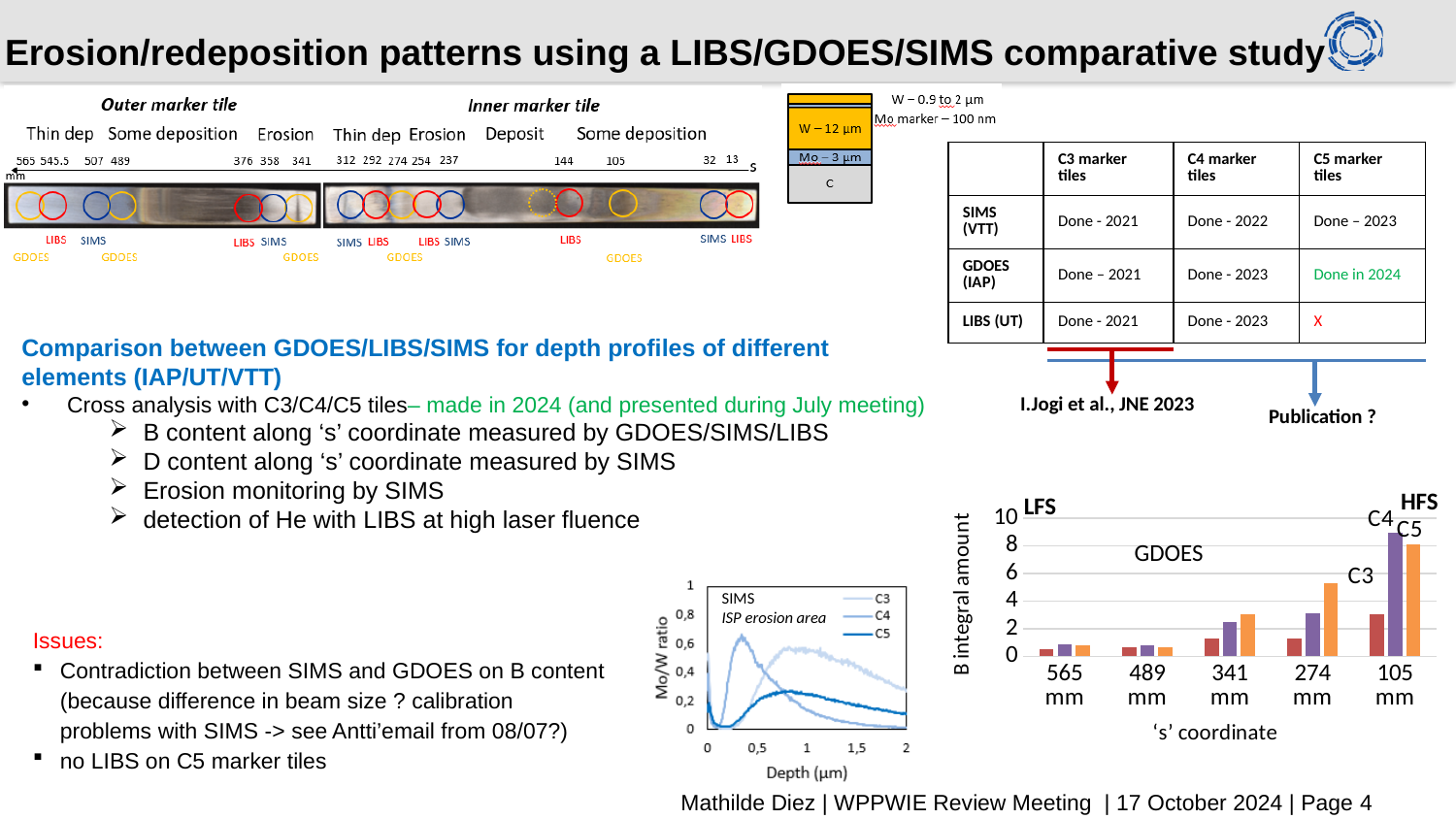
In the GDOES bar chart, which 's' coordinate has the highest C4 bar? 105 mm In the GDOES bar chart, is the C4 value at 105 mm greater or less than 8? greater How many 's' coordinate categories are shown on the x axis of the GDOES bar chart? 5 In the GDOES bar chart, which is larger at 274 mm: the C3 bar or the C5 bar? C5 What is the y-axis label of the GDOES bar chart? B integral amount In the GDOES bar chart, do the C5 values rise or fall moving from 565 mm to 105 mm along the x axis? rise What is the x-axis label of the SIMS line chart? Depth (µm) In the GDOES bar chart, is the C3 value at 565 mm greater or less than 2? less In the GDOES bar chart, is the C5 value at 274 mm greater or less than 4? greater How many series does the legend of the SIMS line chart list? 3 What kind of chart is the SIMS chart showing Mo/W ratio against depth? line chart What kind of chart is the GDOES chart on the lower right of the slide? bar chart